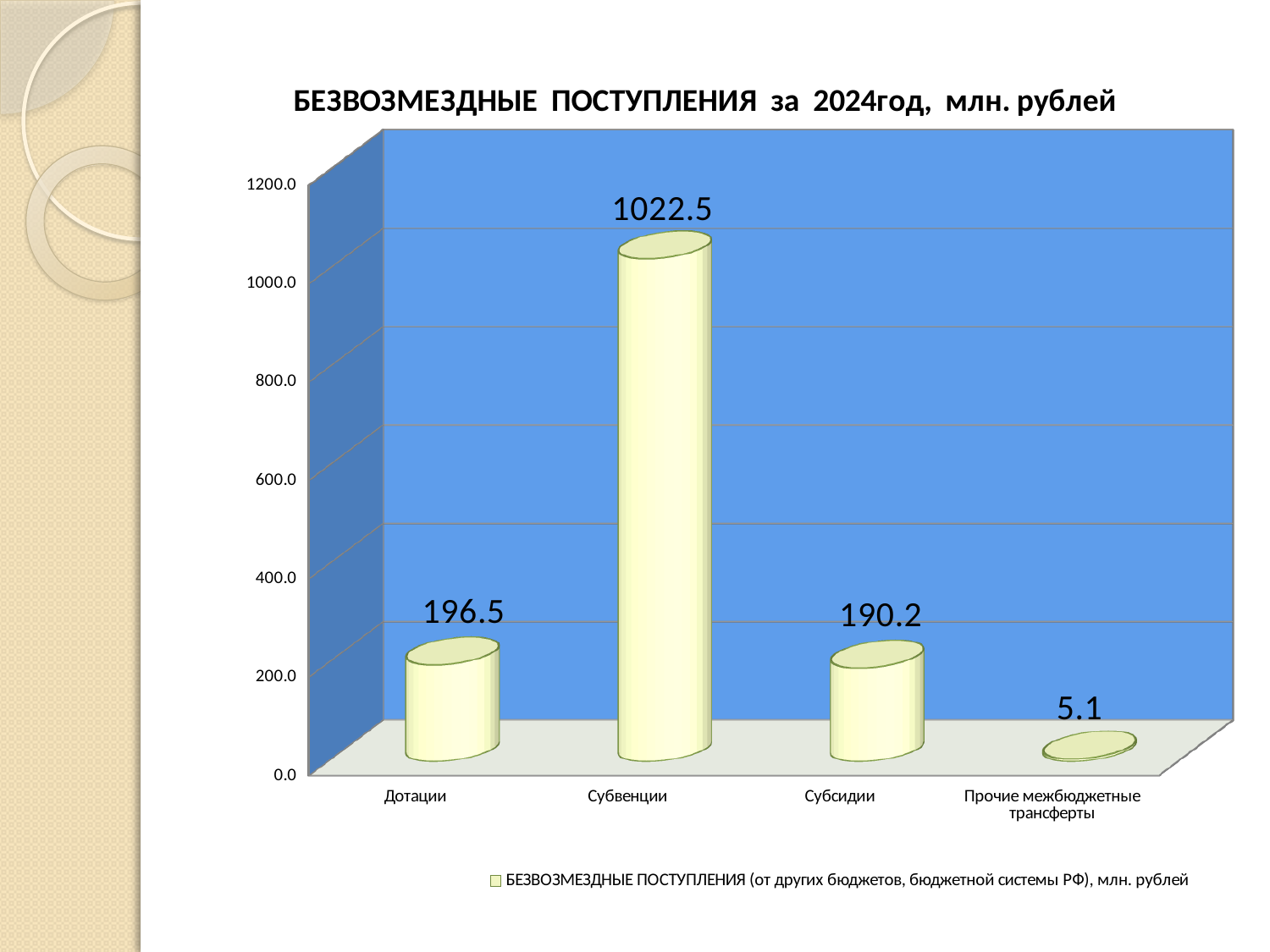
Which is larger, the value for Субвенции or the value for Субсидии? Субвенции How many categories are shown on the x axis? 4 What is the value for Прочие межбюджетные трансферты? 5.1 What is the title of the chart? БЕЗВОЗМЕЗДНЫЕ ПОСТУПЛЕНИЯ за 2024год, млн. рублей What kind of chart is shown on the slide? bar chart What is the difference between the values for Дотации and Субсидии? 6.3 Which category has the highest value? Субвенции Which category has the lowest value? Прочие межбюджетные трансферты What is the difference between the values for Субвенции and Дотации? 826.0 What is the value for Субвенции? 1022.5 What is the value for Дотации? 196.5 What is the value for Субсидии? 190.2